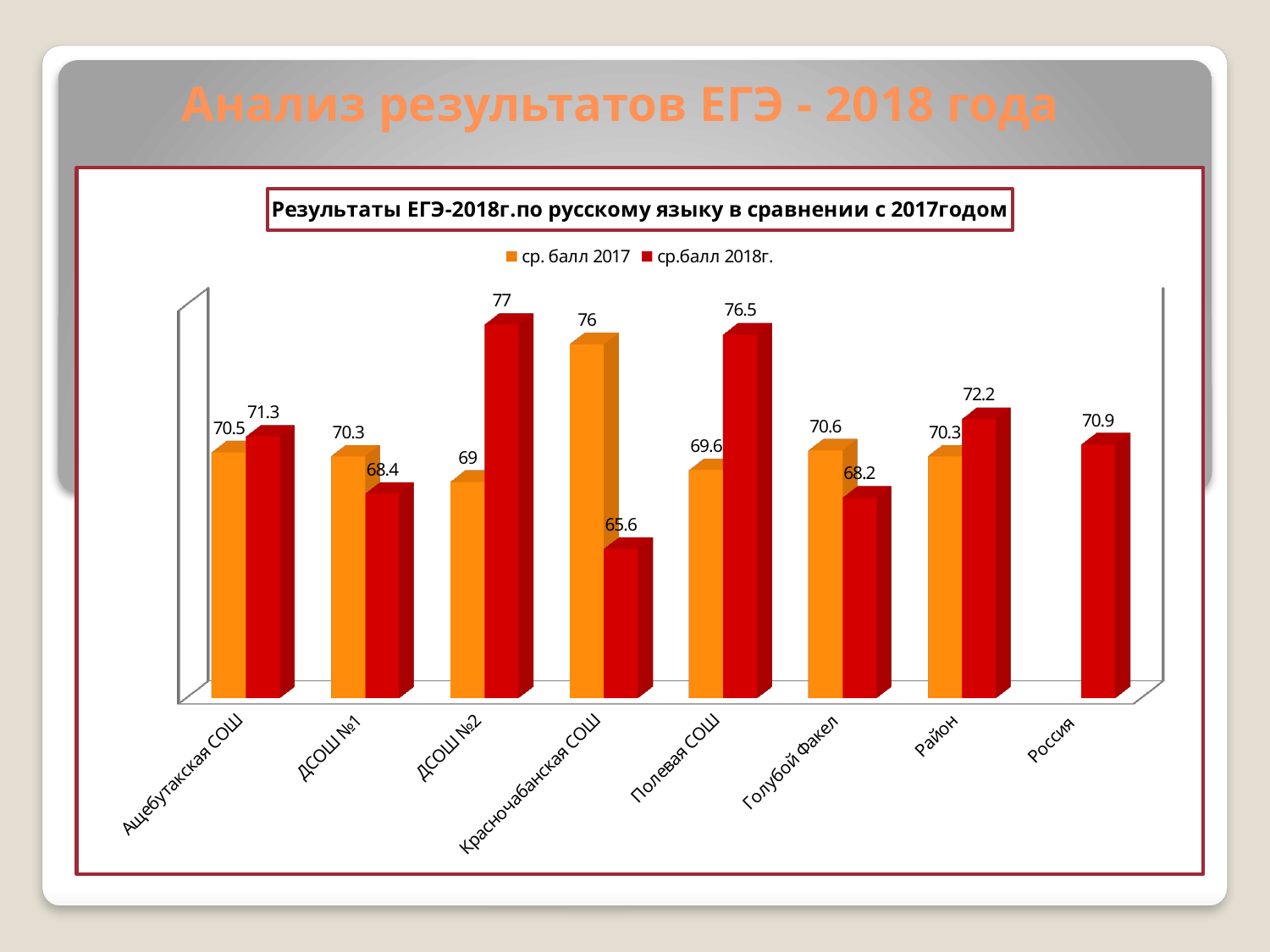
Which category has the highest value for ср.балл 2018г.? ДСОШ №2 What is the difference between ср.балл 2018г. and ср. балл 2017 for Полевая СОШ? 6.9 What type of chart is shown on the slide? Bar chart How many series does the legend list? 2 What is the value of ср.балл 2018г. for ДСОШ №2? 77 What is the title of the chart? Результаты ЕГЭ-2018г.по русскому языку в сравнении с 2017годом What is the value of ср. балл 2017 for Красночабанская СОШ? 76 For Голубой Факел, which is larger: ср. балл 2017 or ср.балл 2018г.? ср. балл 2017 Which category has the lowest value for ср.балл 2018г.? Красночабанская СОШ Which category has the lowest value for ср. балл 2017? ДСОШ №2 What is the value of ср.балл 2018г. for Россия? 70.9 How many categories are shown along the x axis? 8